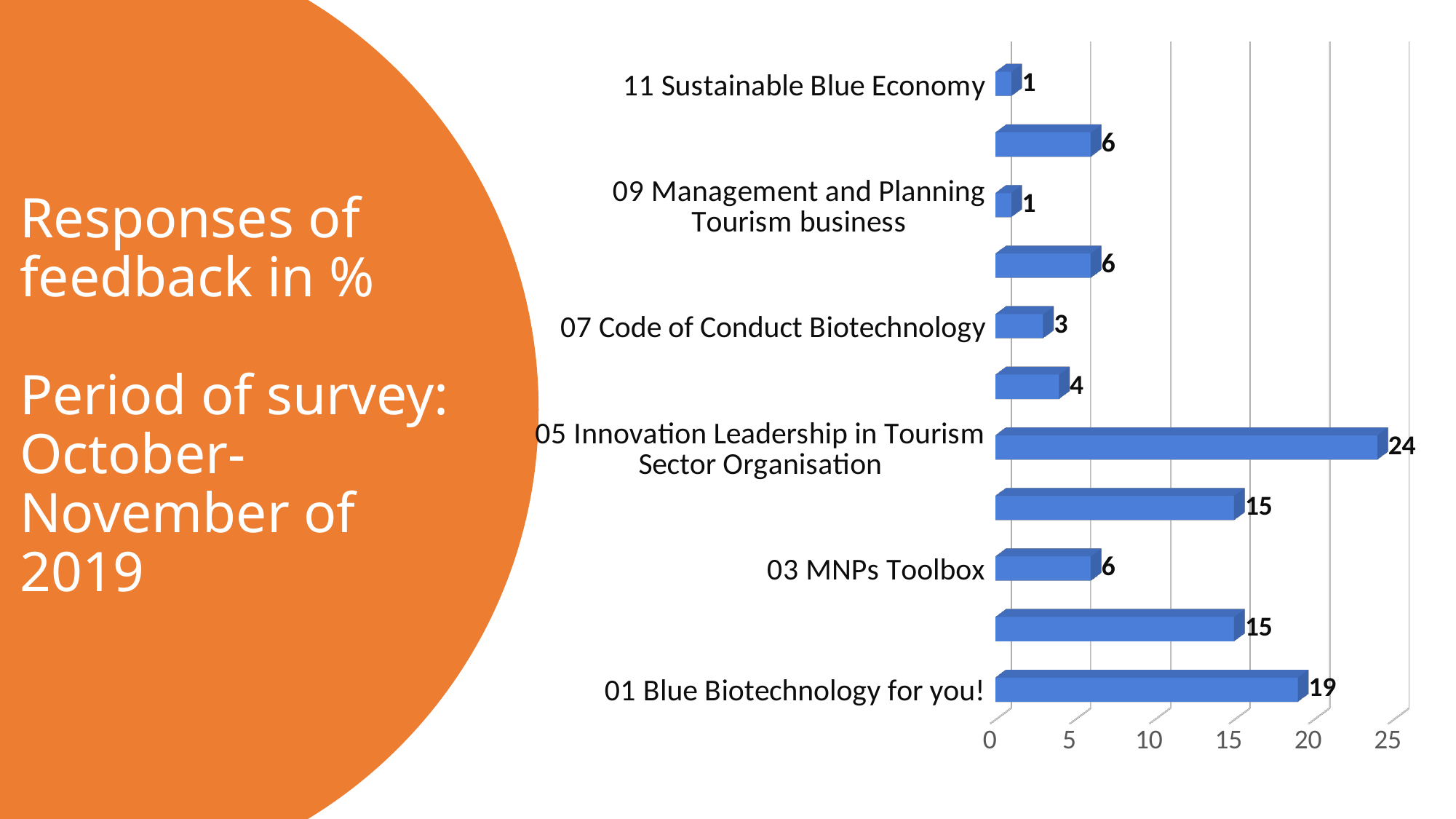
What kind of chart is shown on the slide? bar chart Which is larger, the value for 03 MNPs Toolbox or the value for 07 Code of Conduct Biotechnology? 03 MNPs Toolbox What is the difference between the values for 05 Innovation Leadership in Tourism Sector Organisation and 01 Blue Biotechnology for you!? 5 What is the value for 03 MNPs Toolbox? 6 What is the value for 11 Sustainable Blue Economy? 1 Which category has the highest value? 05 Innovation Leadership in Tourism Sector Organisation What is the value for 01 Blue Biotechnology for you!? 19 What is the value for 05 Innovation Leadership in Tourism Sector Organisation? 24 How many bars are plotted in the chart? 11 What is the difference between the values for 03 MNPs Toolbox and 09 Management and Planning Tourism business? 5 What is the value for 07 Code of Conduct Biotechnology? 3 Is the value for 01 Blue Biotechnology for you! greater or less than 15? greater